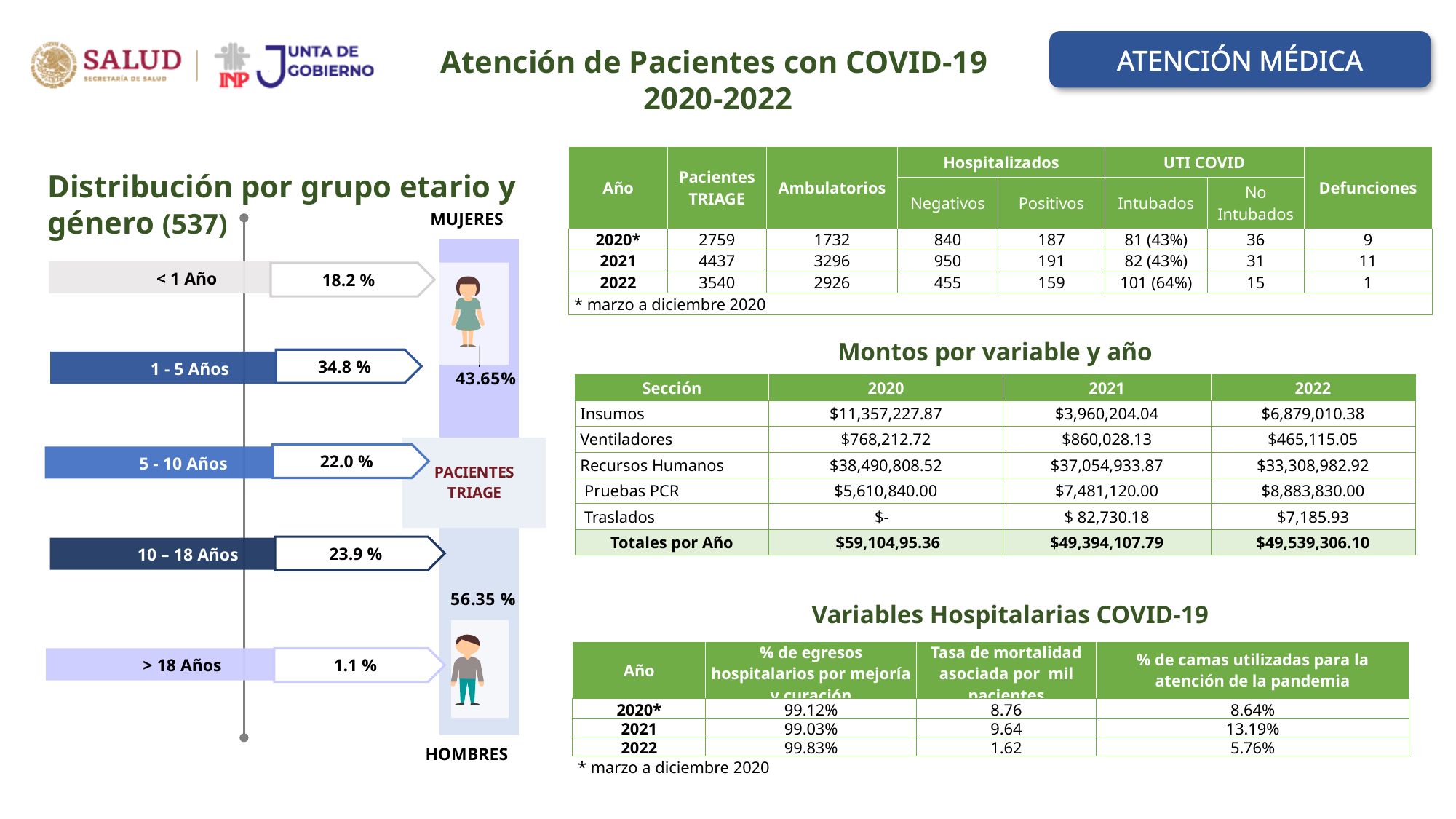
How many age groups are shown in the 'Distribución por grupo etario y género' chart? 5 In the 'Distribución por grupo etario y género' chart, which group has a larger percentage: 5 - 10 Años or 10 – 18 Años? 10 – 18 Años In the 'Distribución por grupo etario y género' chart, what percentage of patients are Mujeres? 43.65% In the 'Distribución por grupo etario y género' chart, what percentage is shown for the < 1 Año group? 18.2 % In the 'Distribución por grupo etario y género' chart, what percentage of patients are Hombres? 56.35 % In the 'Distribución por grupo etario y género' chart, which gender has the larger share of patients, Mujeres or Hombres? Hombres In the 'Distribución por grupo etario y género' chart, which age group has the lowest percentage? > 18 Años In the 'Distribución por grupo etario y género' chart, what is the difference in percentage between the 10 – 18 Años group and the 5 - 10 Años group? 1.9 % In the 'Distribución por grupo etario y género' chart, what percentage is shown for the 1 - 5 Años group? 34.8 % In the 'Distribución por grupo etario y género' chart, which age group has the highest percentage? 1 - 5 Años In the 'Distribución por grupo etario y género' chart, what is the difference between the Hombres and Mujeres percentages? 12.7 % What total number of patients is shown in parentheses in the title of the 'Distribución por grupo etario y género' chart? 537